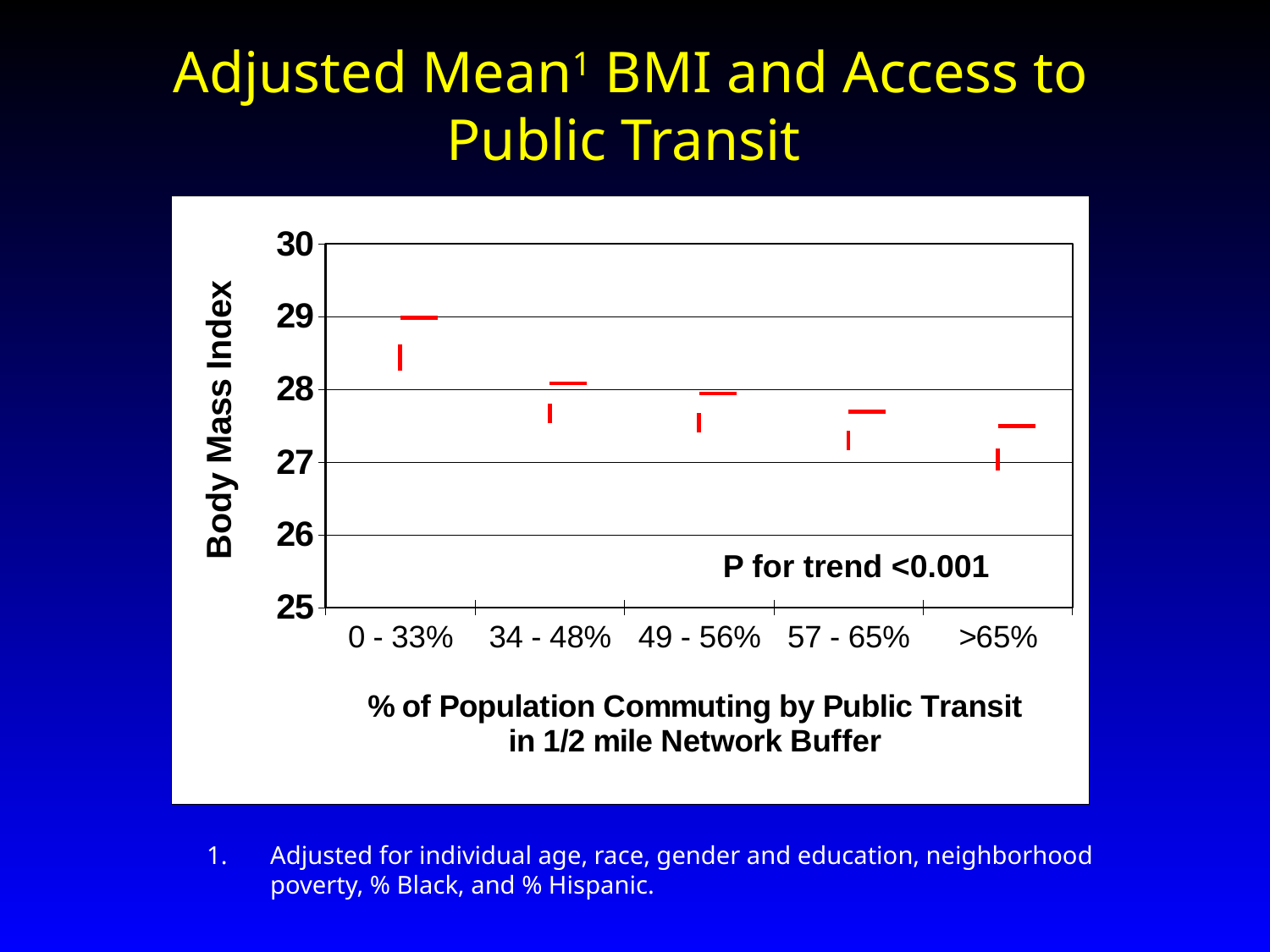
Is the Body Mass Index value for the 34 - 48% category greater or less than 27? greater What P value for trend is annotated on the chart? P for trend <0.001 Is the Body Mass Index value for the >65% category greater or less than 28? less How many categories are shown on the x axis of the chart? 5 Which category has the highest Body Mass Index value? 0 - 33% Do the Body Mass Index values rise or fall as the % of population commuting by public transit increases along the x axis? fall Is the Body Mass Index value for the 57 - 65% category greater or less than 28? less Which has the larger Body Mass Index value, the 34 - 48% category or the 57 - 65% category? 34 - 48% What is the label of the y axis of the chart? Body Mass Index Which has the larger Body Mass Index value, the 0 - 33% category or the >65% category? 0 - 33% Which category has the lowest Body Mass Index value? >65%